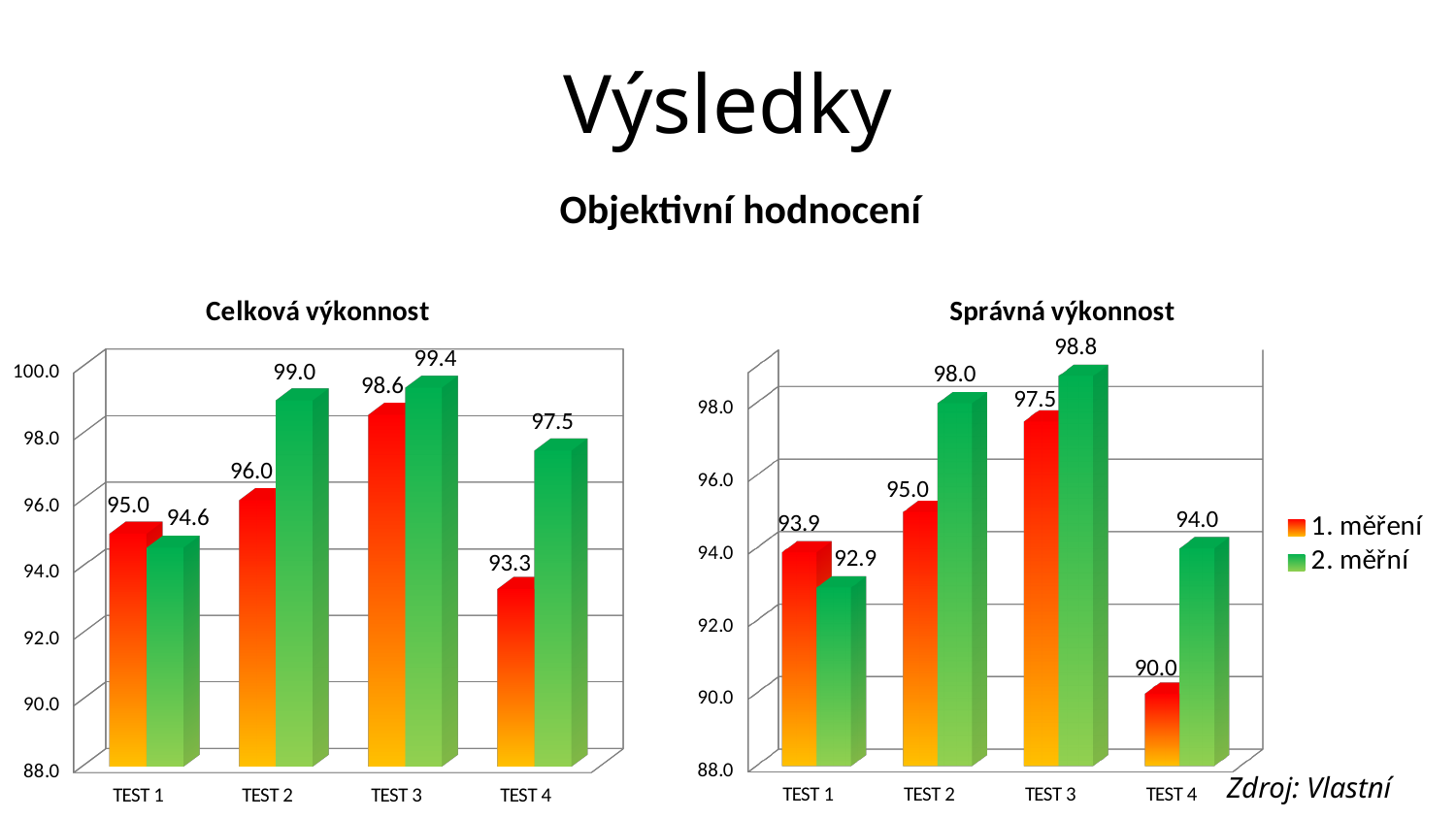
In the 'Správná výkonnost' chart, what is the value of the 2. měrní bar for TEST 2? 98.0 In the 'Celková výkonnost' chart, what is the difference between the 2. měrní and 1. měření values for TEST 4? 4.2 In the 'Správná výkonnost' chart, which test has the lowest 1. měření value? TEST 4 In the 'Celková výkonnost' chart, which test has the highest 2. měrní (green) value? TEST 3 In the 'Správná výkonnost' chart, what is the difference between the 2. měrní and 1. měření values for TEST 1? 1.0 How many series does the legend list? 2 In the 'Celková výkonnost' chart, what is the value of the 1. měření (red) bar for TEST 3? 98.6 How many tests are shown on the x axis of the 'Správná výkonnost' chart? 4 In the 'Správná výkonnost' chart, what is the value of the 1. měření bar for TEST 4? 90.0 In the 'Celková výkonnost' chart, which is larger for TEST 1: the 1. měření value or the 2. měrní value? 1. měření What type of chart is 'Celková výkonnost'? Bar chart In the 'Celková výkonnost' chart, what is the value of the 2. měrní (green) bar for TEST 4? 97.5